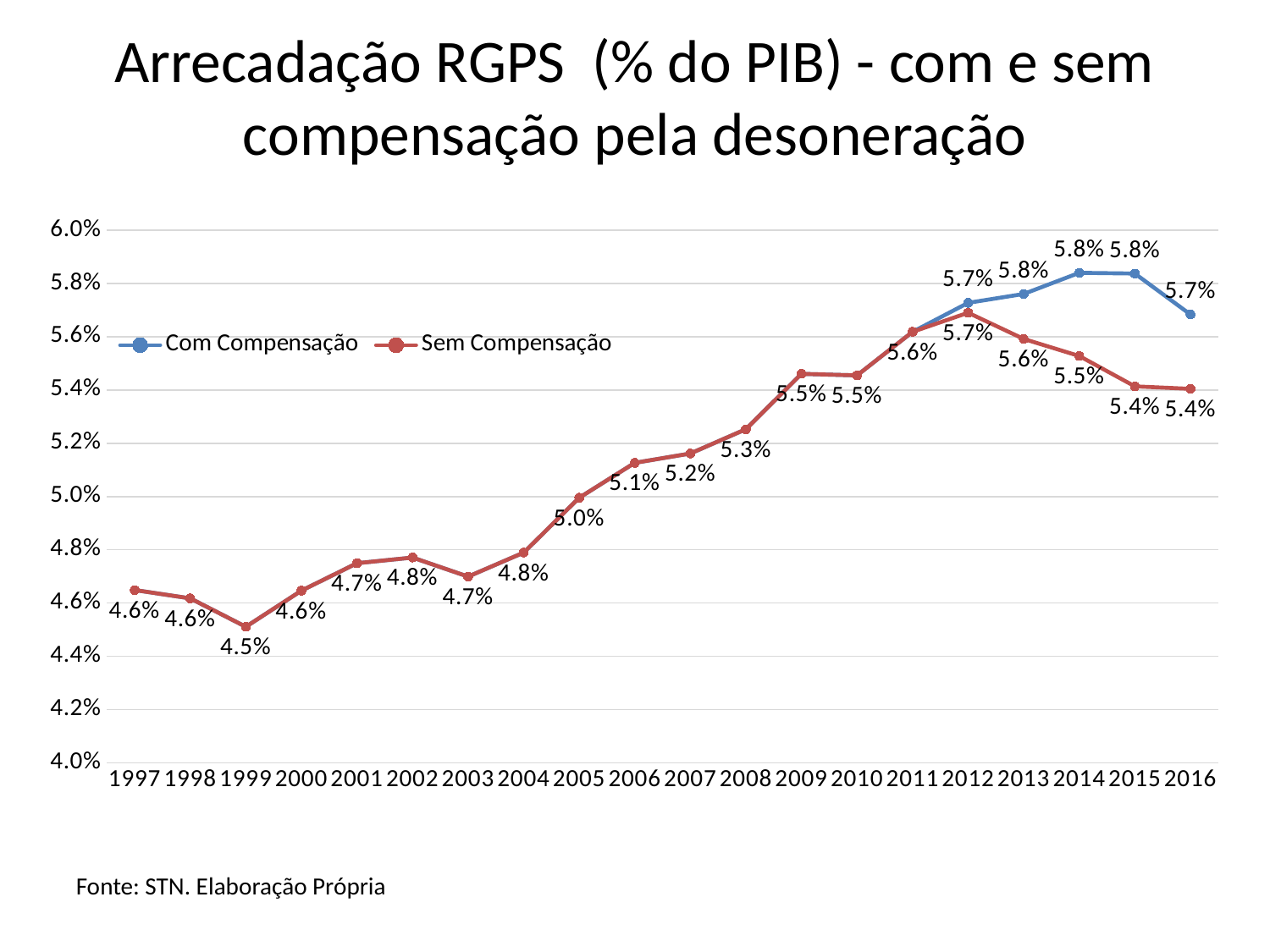
In 2016, which series has the larger value, Com Compensação or Sem Compensação? Com Compensação What is the value for Sem Compensação in 2016? 5.4% How many years are shown on the x axis? 20 How many series does the legend list? 2 Does the Sem Compensação series rise or fall from 1999 to 2012? rise What is the difference between Com Compensação and Sem Compensação in 2013? 0.2 percentage points Is the value for 2008 greater or less than 5.2%? greater In which year is the Sem Compensação series at its lowest? 1999 What is the value for Sem Compensação in 1999? 4.5% What kind of chart is shown on the slide? line chart What is the value for Com Compensação in 2014? 5.8% In which year is the Sem Compensação series at its highest? 2012